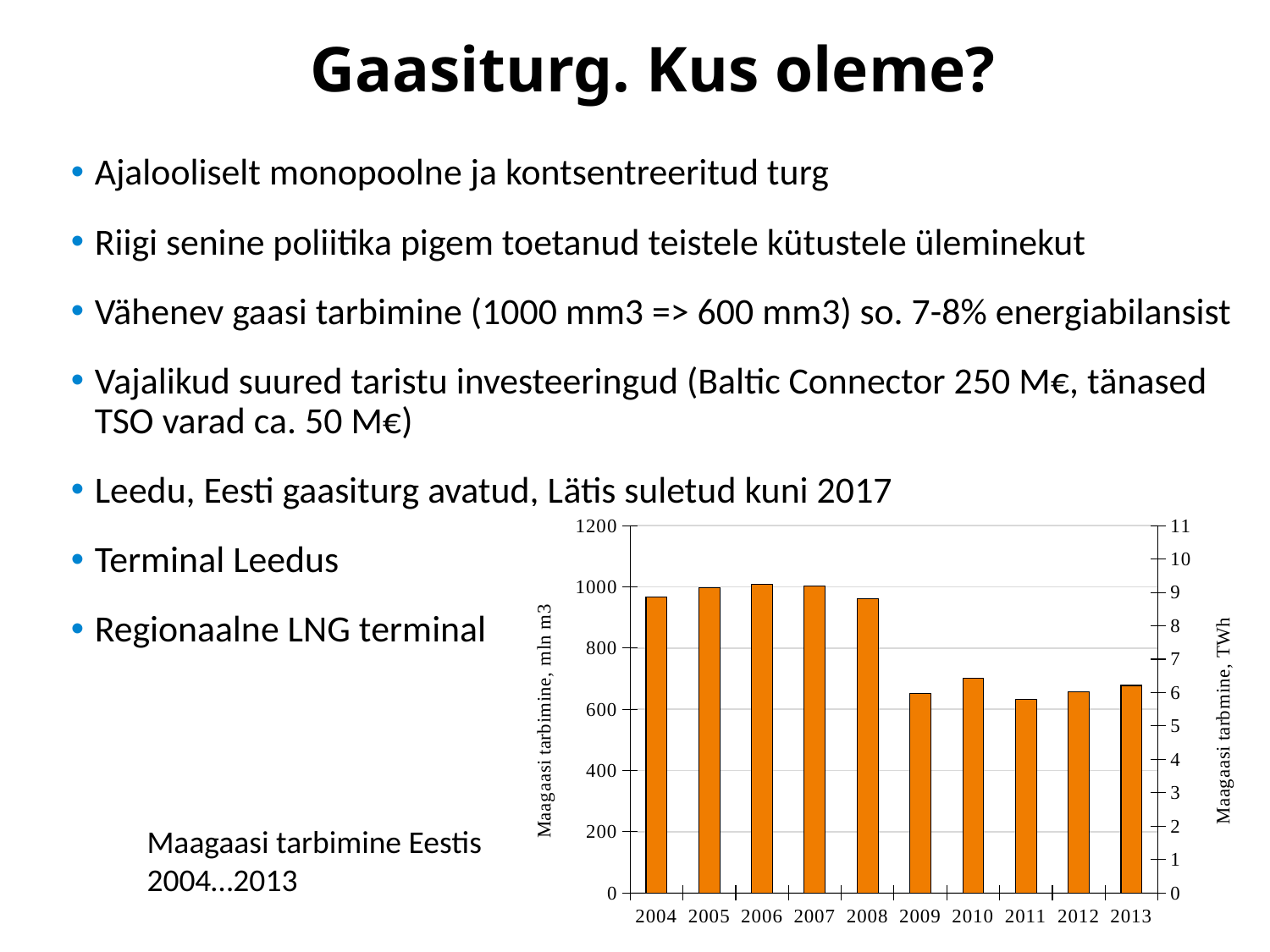
Is the value for 2010 greater or less than 600? greater Which is larger, the value for 2004 or the value for 2009? 2004 What caption is given for the chart on the slide? Maagaasi tarbimine Eestis 2004…2013 What is the label of the left vertical axis of the chart? Maagaasi tarbimine, mln m3 Which is larger, the value for 2010 or the value for 2011? 2010 Is the value for 2013 greater or less than 800? less What kind of chart is shown on the slide? bar chart Overall, do the values rise or fall from 2004 to 2013? fall How many years are plotted on the x axis of the chart? 10 Is the value for 2004 greater or less than 800? greater